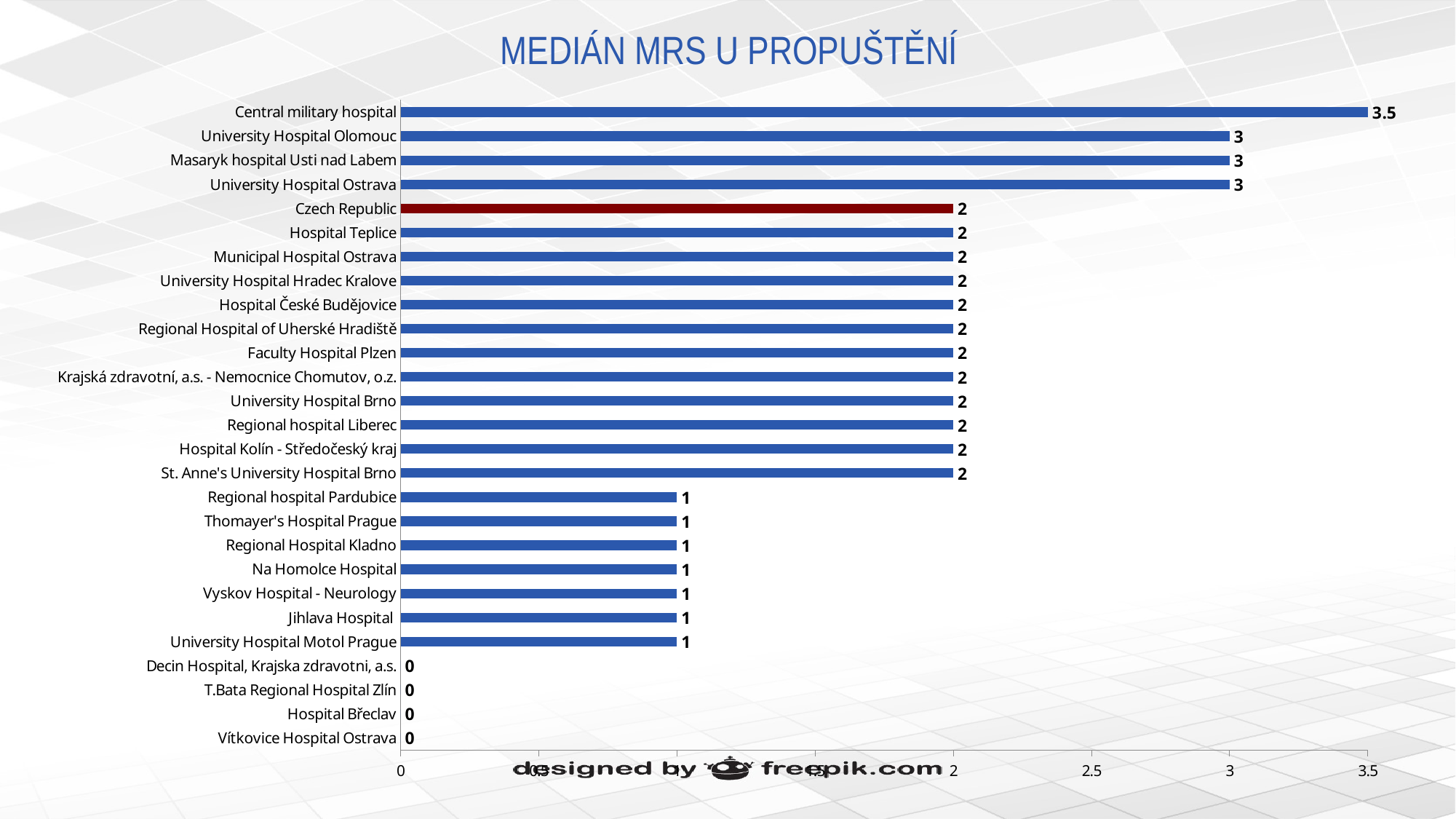
Is the value for Masaryk hospital Usti nad Labem greater or less than 2.5? greater What is the value shown for University Hospital Motol Prague? 1 What is the median mRS at discharge for Central military hospital? 3.5 Which hospital has the highest median mRS at discharge? Central military hospital What is the value shown for Vítkovice Hospital Ostrava? 0 How many hospitals/categories are listed on the chart? 27 What is the title of the chart? MEDIÁN MRS U PROPUŠTĚNÍ What is the difference between the value for Central military hospital and the value for Czech Republic? 1.5 What kind of chart is shown on the slide? bar chart What is the value shown for Czech Republic? 2 Which is larger, the value for University Hospital Olomouc or the value for Regional hospital Pardubice? University Hospital Olomouc Which category's bar is coloured dark red instead of blue? Czech Republic